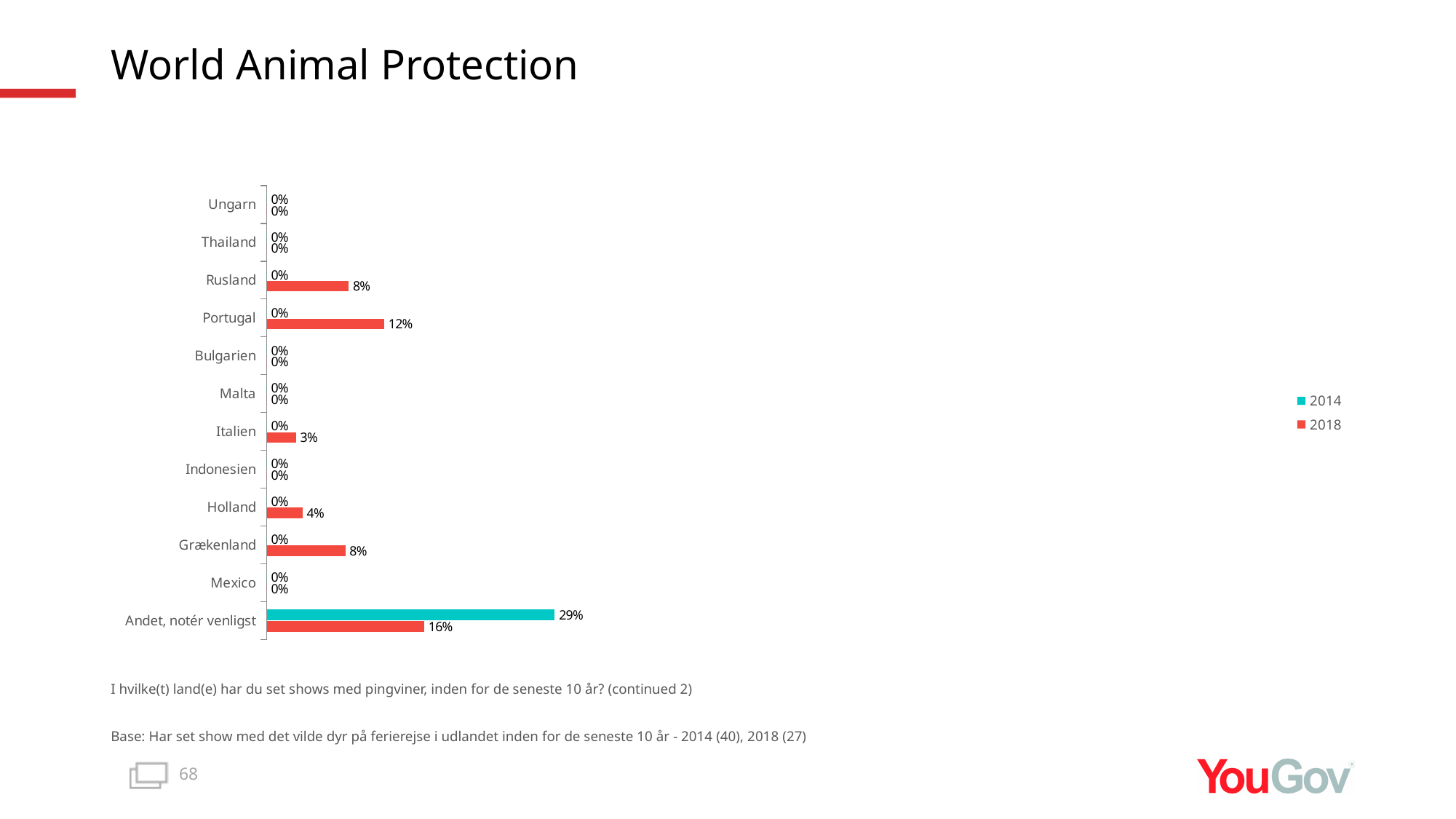
Which series is shown in red in the legend? 2018 What is the difference between the 2014 and 2018 values for Andet, notér venligst? 13% What is the 2018 value for Italien? 3% What is the 2014 value for Andet, notér venligst? 29% How many categories are shown on the y axis? 12 What is the difference between the 2018 values for Portugal and Rusland? 4% What kind of chart is shown on the slide? Bar chart How many series does the legend list? 2 Which category has the highest 2018 value? Andet, notér venligst What is the 2018 value for Holland? 4% What is the 2018 value for Portugal? 12% Which is larger, the 2018 value for Grækenland or the 2018 value for Holland? Grækenland